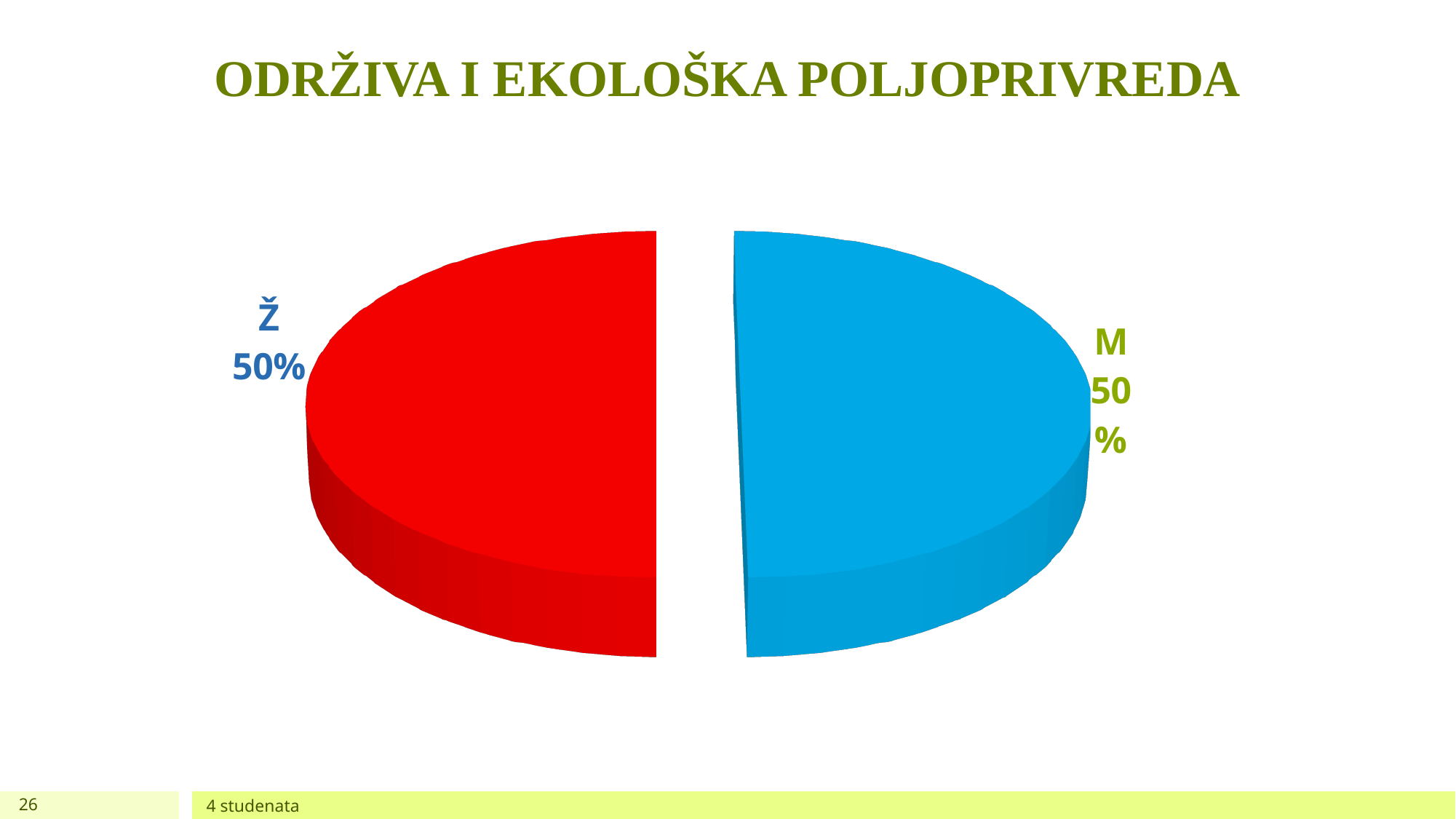
What kind of chart is shown on the slide? pie chart What is the title of the slide containing the pie chart? ODRŽIVA I EKOLOŠKA POLJOPRIVREDA What colour is the Ž slice of the pie chart? red How many slices does the pie chart have? 2 What is the difference between the Ž share and the M share? 0% Is the share for Ž greater than, less than, or equal to the share for M? equal What share of the pie does the M slice represent? 50% What is the combined share of the Ž and M slices? 100% What share of the pie does the Ž slice represent? 50%